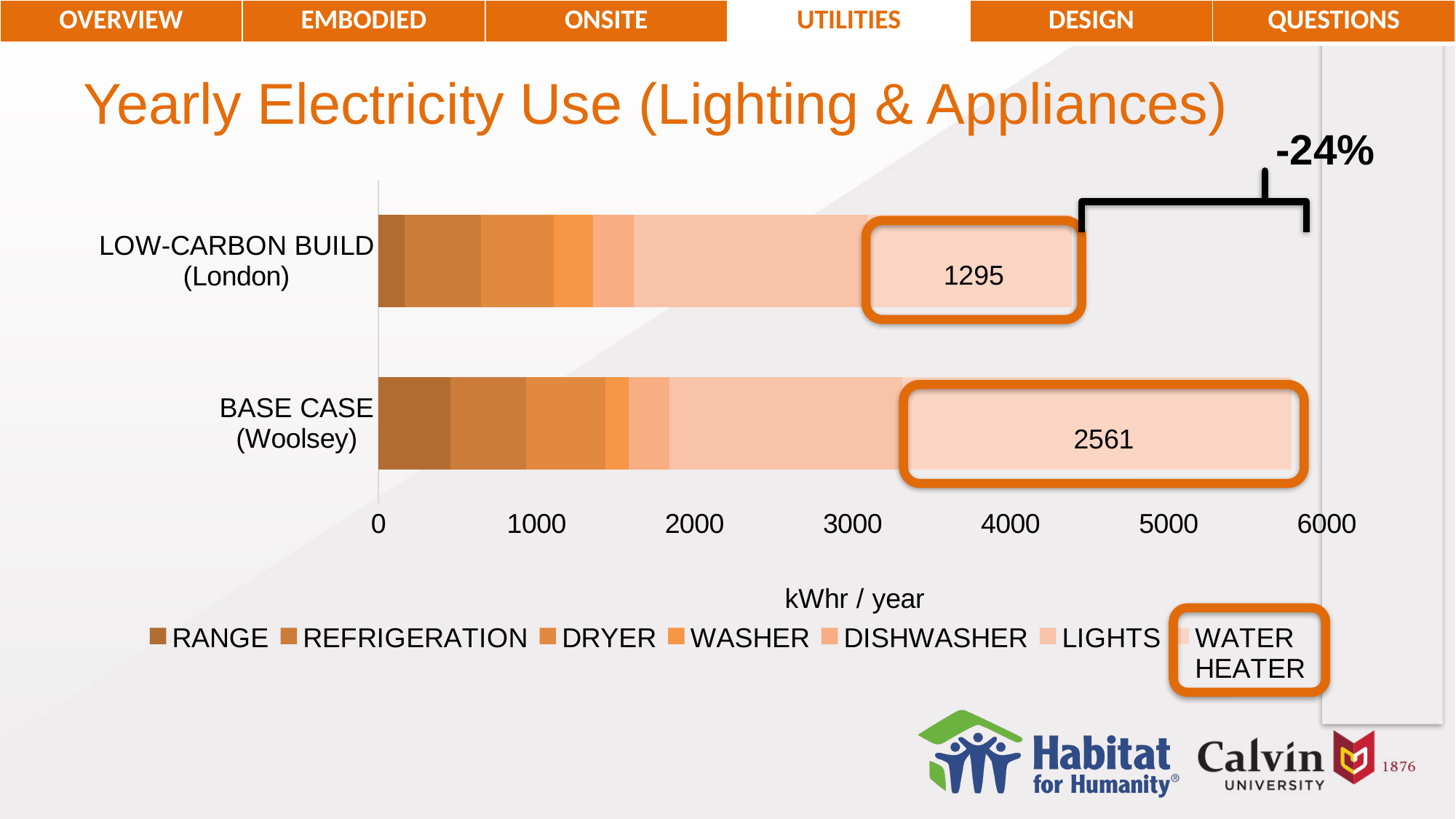
Is the total value of the Base Case (Woolsey) bar greater or less than 5000? greater How many series does the legend list? 7 Which category has the longest total bar? Base Case (Woolsey) What is the title of the chart? Yearly Electricity Use (Lighting & Appliances) What is the Water Heater value for the Low-Carbon Build (London) bar? 1295 Is the total value of the Low-Carbon Build (London) bar greater or less than 5000? less What kind of chart is shown on the slide? Stacked bar chart What unit is shown on the x axis of the chart? kWhr / year What is the difference between the Water Heater values of the Base Case (Woolsey) and the Low-Carbon Build (London)? 1266 What is the Water Heater value for the Base Case (Woolsey) bar? 2561 Which has the larger Water Heater value, the Base Case (Woolsey) or the Low-Carbon Build (London)? Base Case (Woolsey) How many categories (bars) are shown in the chart? 2